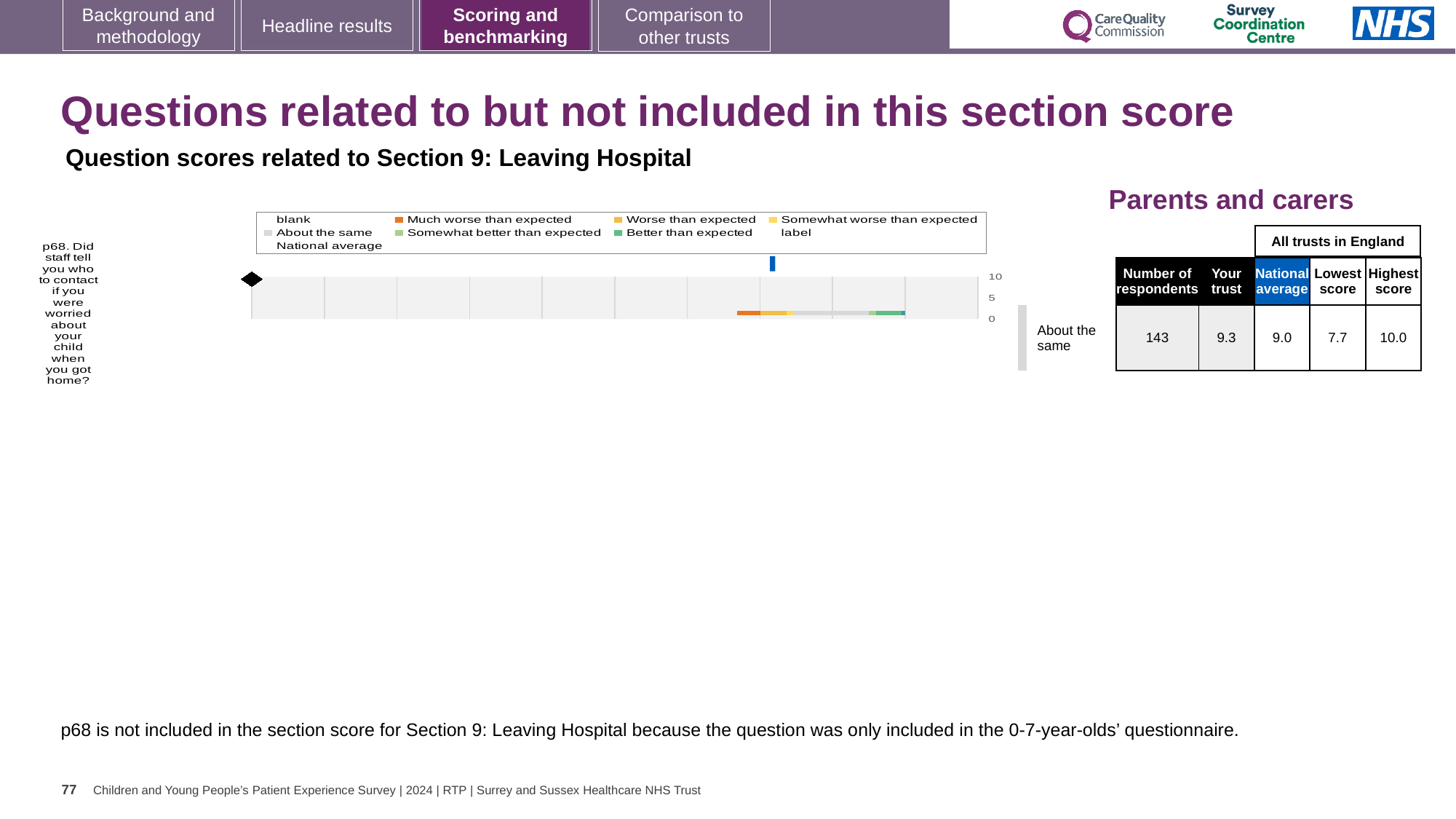
According to the table beside the chart, what is the highest score among all trusts in England for p68? 10.0 According to the table beside the chart, what is the 'Your trust' score for p68? 9.3 According to the table beside the chart, what is the lowest score among all trusts in England for p68? 7.7 Which question number is plotted in the chart? p68 What kind of chart is shown on the slide? bar chart Which is larger for p68, the trust's score or the national average? the trust's score According to the table beside the chart, how many respondents answered p68? 143 What is the highest value shown on the chart's axis? 10 According to the table beside the chart, what is the national average score for p68? 9.0 What is the difference between the trust's score and the national average for p68? 0.3 How many questions are plotted in the chart? 1